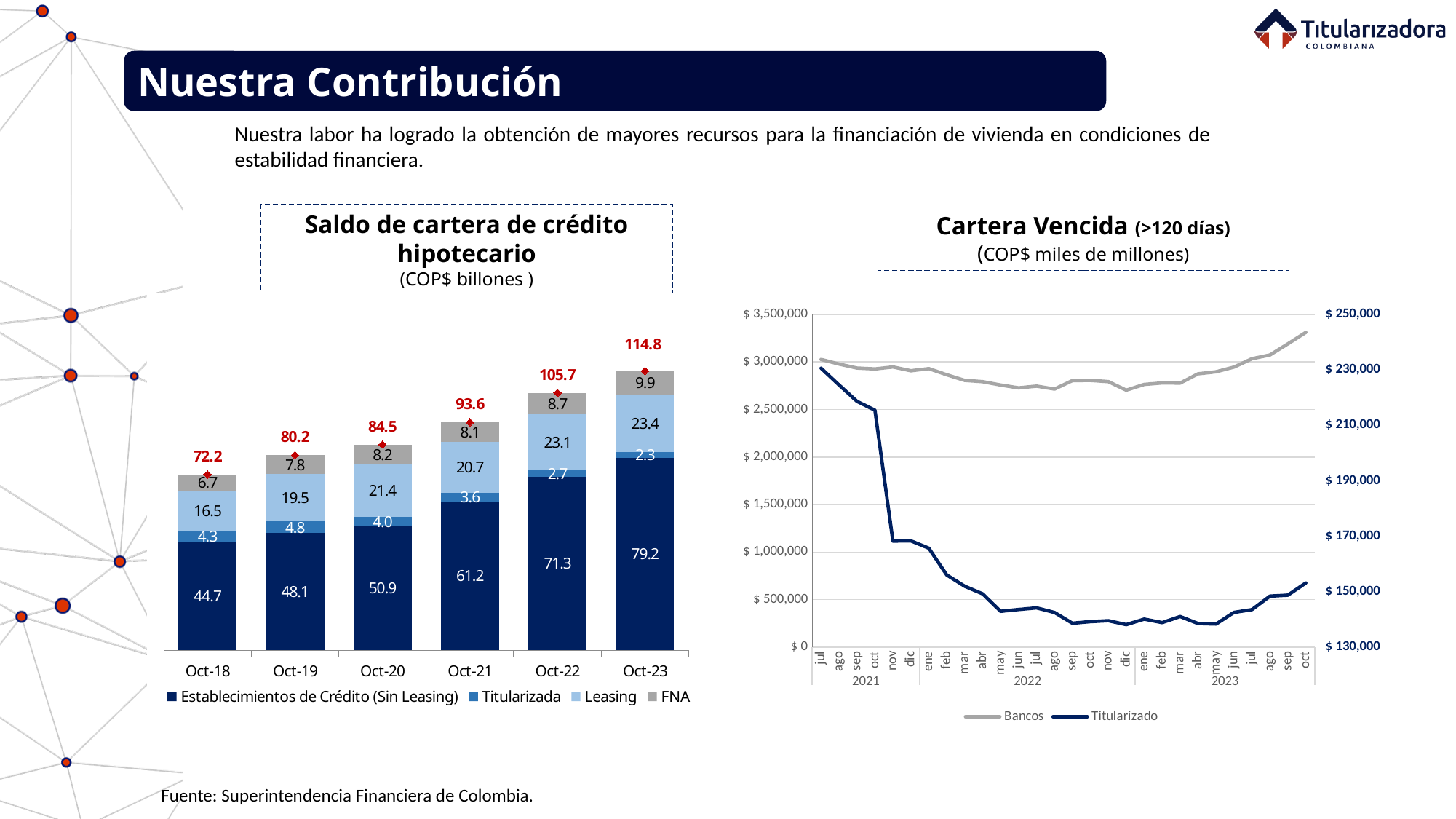
In the 'Saldo de cartera de crédito hipotecario' chart, do the totals rise or fall from Oct-18 to Oct-23? rise In the 'Saldo de cartera de crédito hipotecario' chart, what is the difference between the totals for Oct-23 and Oct-22? 9.1 In the 'Saldo de cartera de crédito hipotecario' chart, what is the total value shown for Oct-23? 114.8 In the 'Saldo de cartera de crédito hipotecario' chart, what is the Titularizada value for Oct-19? 4.8 In the 'Saldo de cartera de crédito hipotecario' chart, which year has the lowest total? Oct-18 In the 'Saldo de cartera de crédito hipotecario' chart, what is the Leasing value for Oct-21? 20.7 In the 'Saldo de cartera de crédito hipotecario' chart, how many series does the legend list? 4 In the 'Saldo de cartera de crédito hipotecario' chart, what is the FNA value for Oct-22? 8.7 In the 'Saldo de cartera de crédito hipotecario' chart, which is larger: the Establecimientos de Crédito (Sin Leasing) value for Oct-20 or for Oct-21? Oct-21 In the 'Cartera Vencida (>120 días)' chart, how many series does the legend list? 2 In the 'Saldo de cartera de crédito hipotecario' chart, how many years are shown on the x axis? 6 What kind of chart is the 'Cartera Vencida (>120 días)' chart? line chart